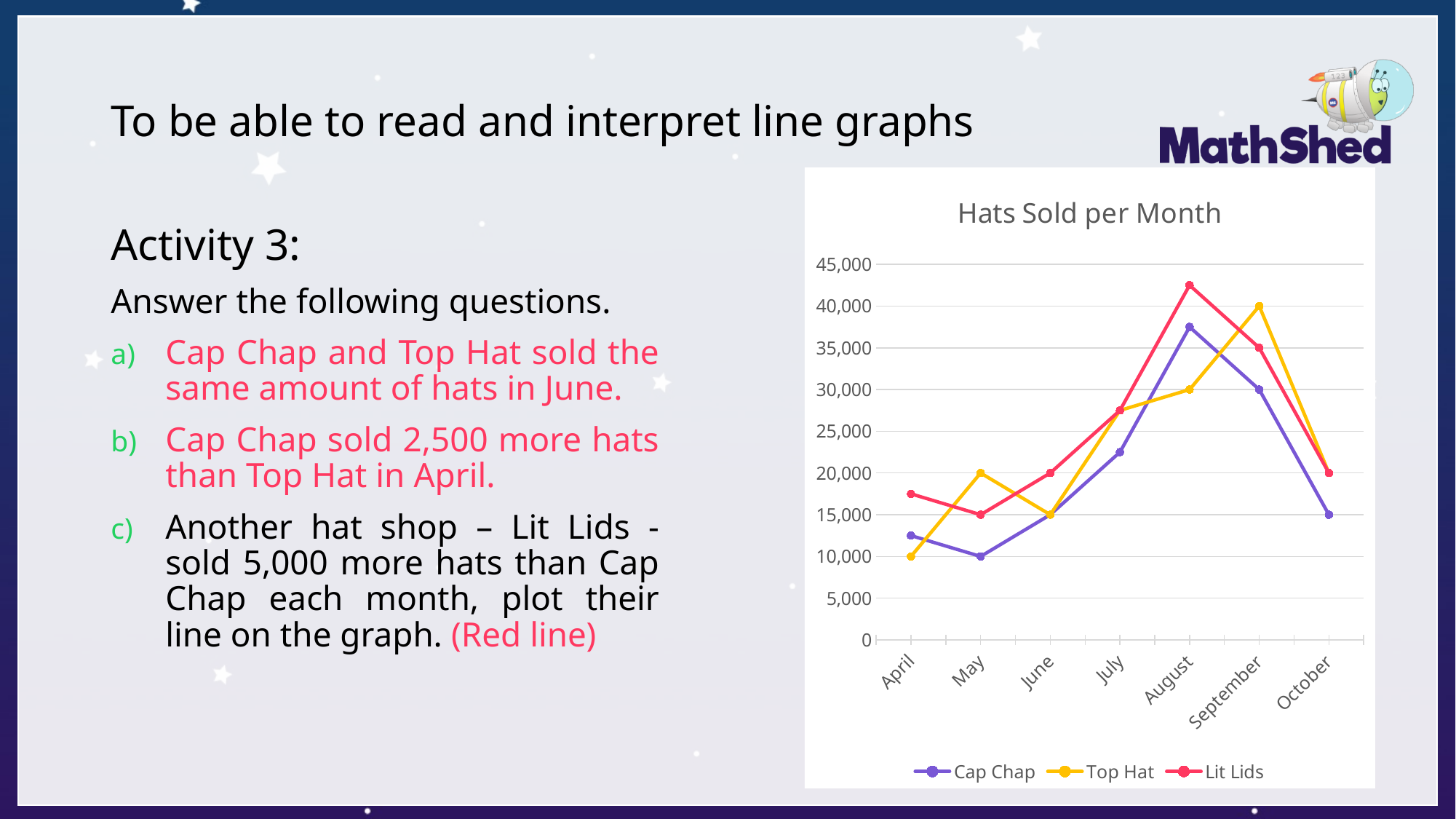
How many months are shown on the x axis of the chart? 7 How many hats did Top Hat sell in September? 40,000 What is the title of the chart? Hats Sold per Month In which month did Lit Lids sell the most hats? August How many more hats did Top Hat sell than Cap Chap in September? 10,000 Is the value for Lit Lids in August greater or less than 40,000? greater How many series does the legend of the chart list? 3 How many hats did Cap Chap sell in May? 10,000 How many hats did Lit Lids sell in June? 20,000 In September, which sold more hats: Top Hat or Cap Chap? Top Hat Do Cap Chap's sales rise or fall from September to October? fall What kind of chart is shown on the slide? line chart